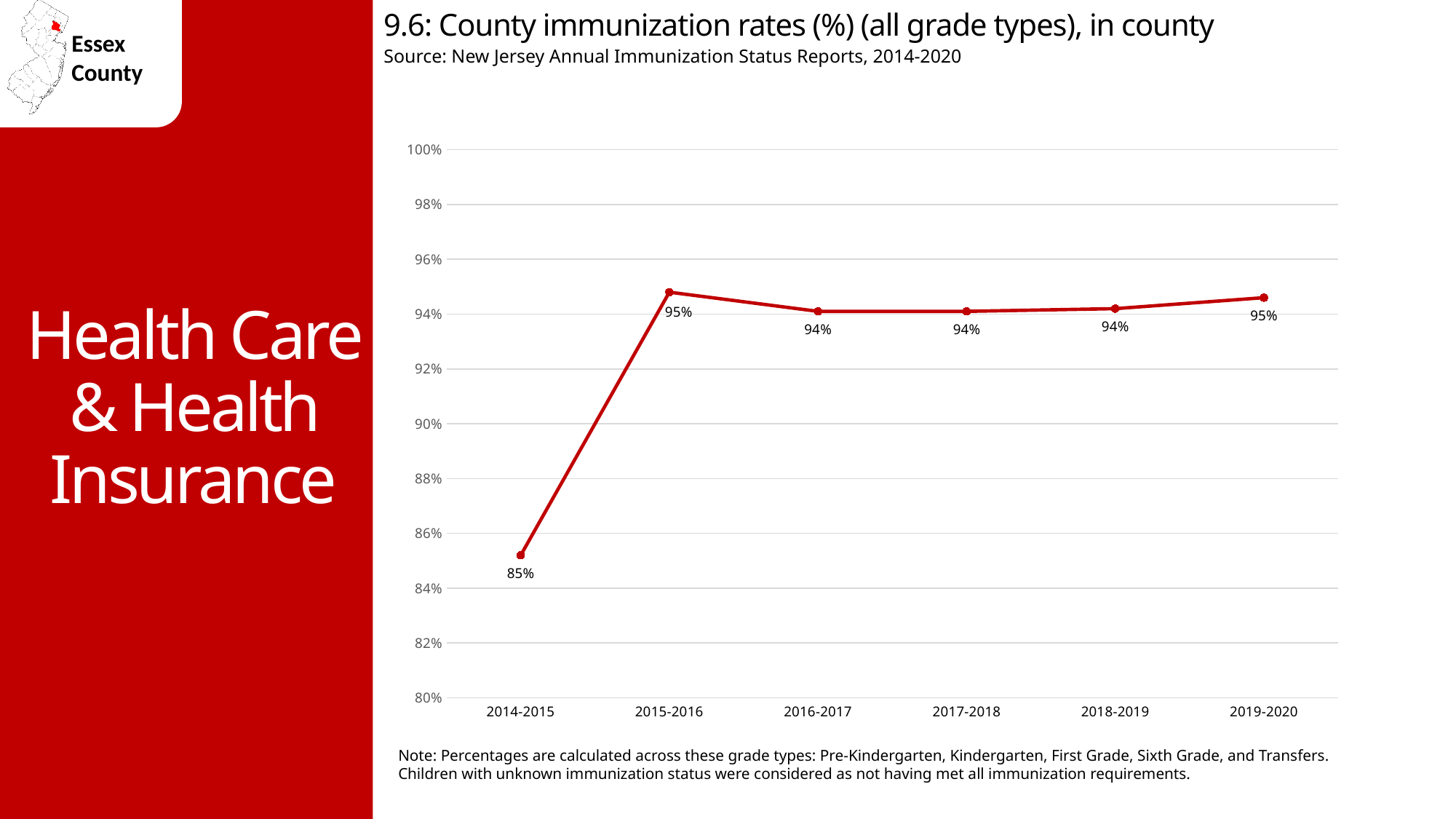
What is the county immunization rate for 2015-2016? 95% How many school years are plotted on the chart? 6 What kind of chart is shown on the slide? line chart Is the value for 2014-2015 greater or less than 86%? less What is the county immunization rate for 2014-2015? 85% What is the county immunization rate for 2019-2020? 95% Does the immunization rate rise or fall from 2014-2015 to 2015-2016? rise Which school year has the lowest county immunization rate? 2014-2015 Which has a higher immunization rate, 2014-2015 or 2016-2017? 2016-2017 What is the county immunization rate for 2017-2018? 94% By how many percentage points did the immunization rate increase from 2014-2015 to 2015-2016? 10 Is the value for 2018-2019 greater or less than 92%? greater